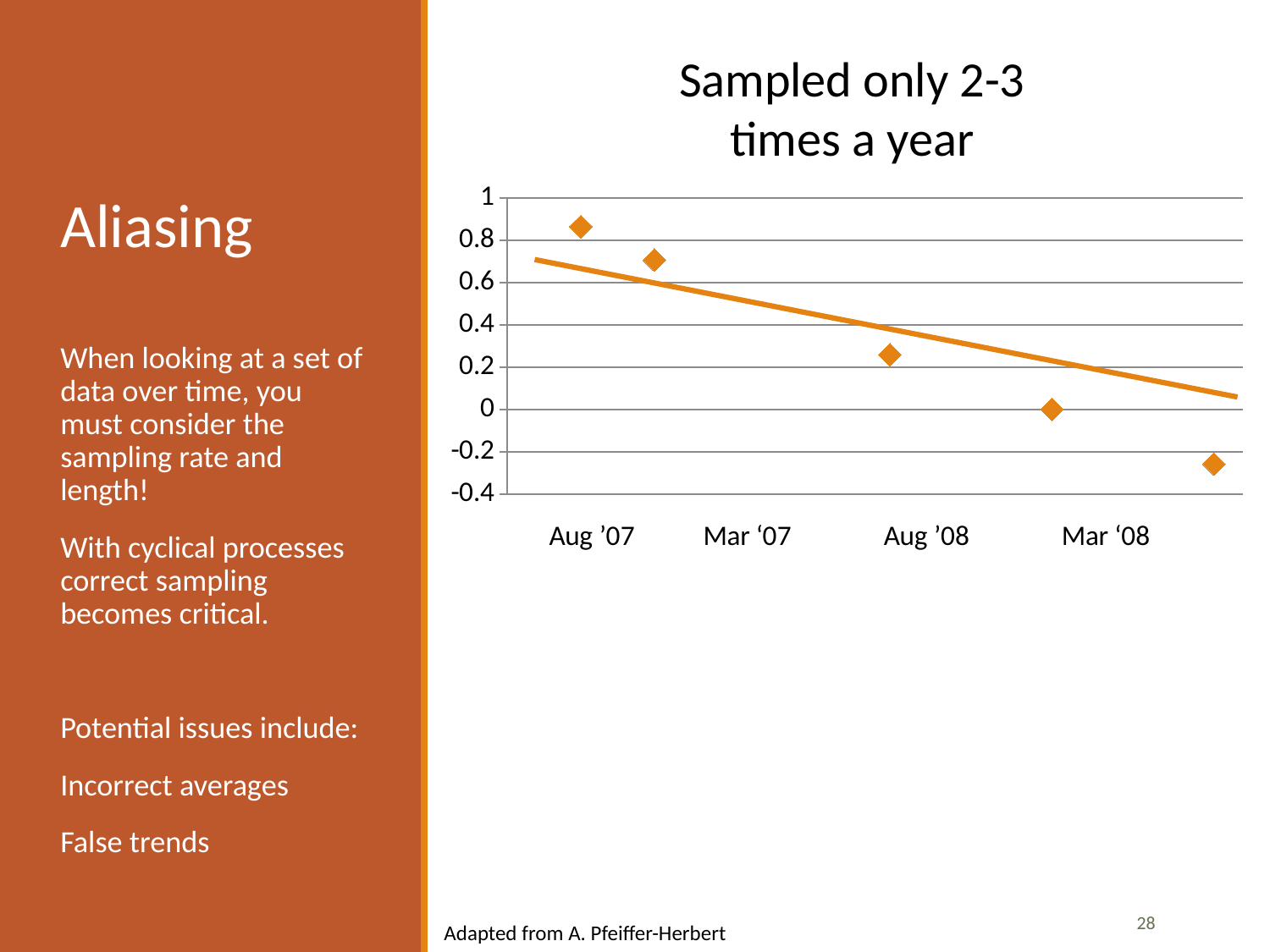
What is the lowest value shown on the chart's y axis? -0.4 Is the value of the leftmost data point greater or less than 0.8? greater Do the plotted values rise or fall from left to right along the x axis? fall Which data point has the lowest value on the chart? the rightmost point Is the value of the third data point from the left greater or less than 0.4? less How many data points are plotted on the chart? 5 Which data point has the highest value, the leftmost or the rightmost? leftmost Is the value of the rightmost data point greater or less than 0? less What kind of chart is shown on the slide? scatter chart What is the title of the chart? Sampled only 2-3 times a year Is the leftmost data point higher or lower than the second data point from the left? higher